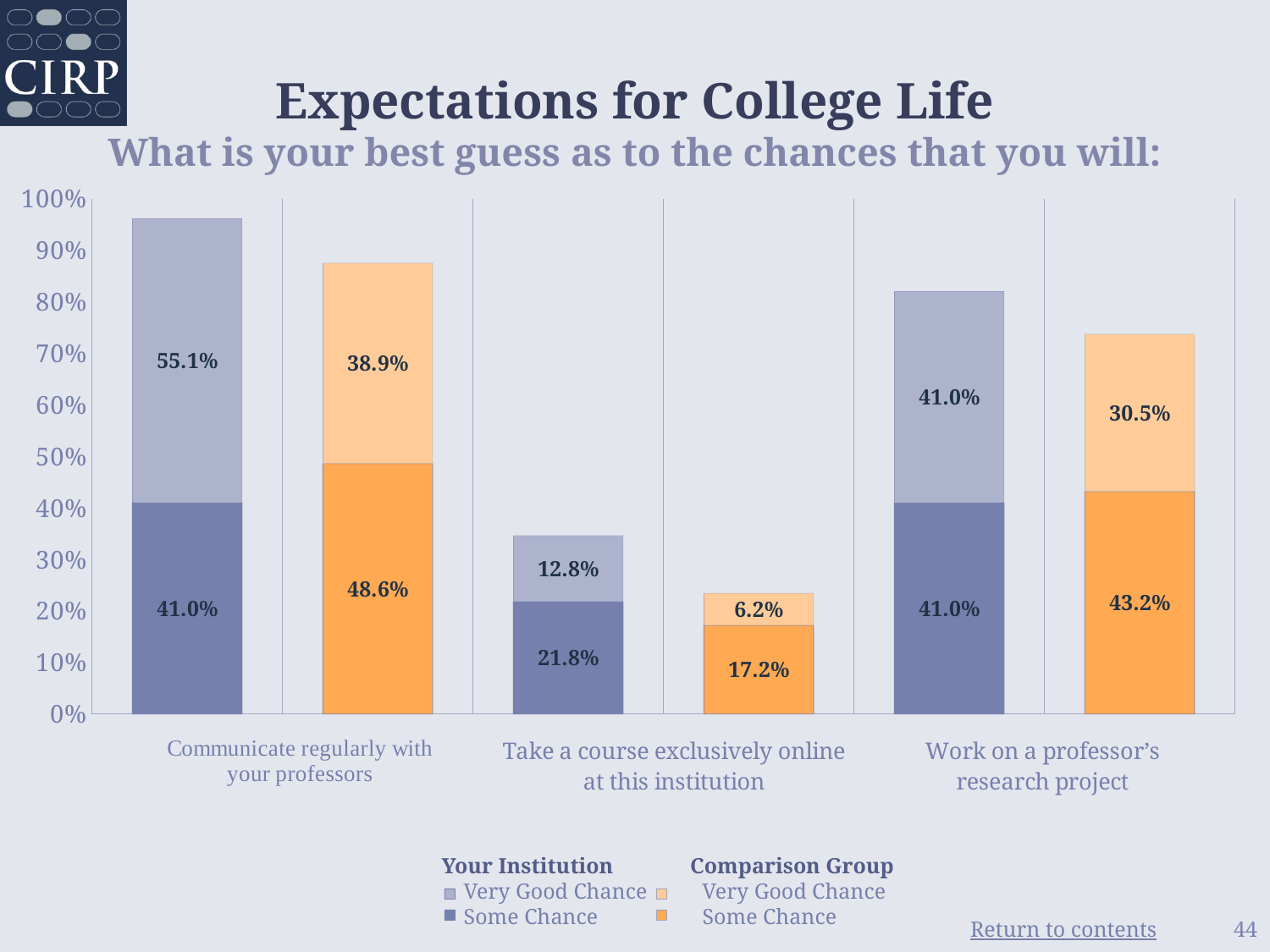
Which is larger: the Your Institution Some Chance value or the Comparison Group Some Chance value for working on a professor's research project? Comparison Group Which category has the lowest Comparison Group Very Good Chance value? Take a course exclusively online at this institution What is the total height of the Comparison Group stacked bar for 'Take a course exclusively online at this institution'? 23.4% What percentage of Your Institution respondents said there is a Very Good Chance they will communicate regularly with their professors? 55.1% What is the Comparison Group's Very Good Chance value for working on a professor's research project? 30.5% What type of chart is shown on the slide? Stacked bar chart How many series does the legend list? 4 How many categories are shown on the x axis? 3 What is the Your Institution Some Chance value for taking a course exclusively online at this institution? 21.8% What is the difference between the Your Institution and Comparison Group Very Good Chance values for communicating regularly with professors? 16.2% What is the total height of the Your Institution stacked bar for 'Communicate regularly with your professors'? 96.1% What is the Comparison Group's Some Chance value for taking a course exclusively online at this institution? 17.2%